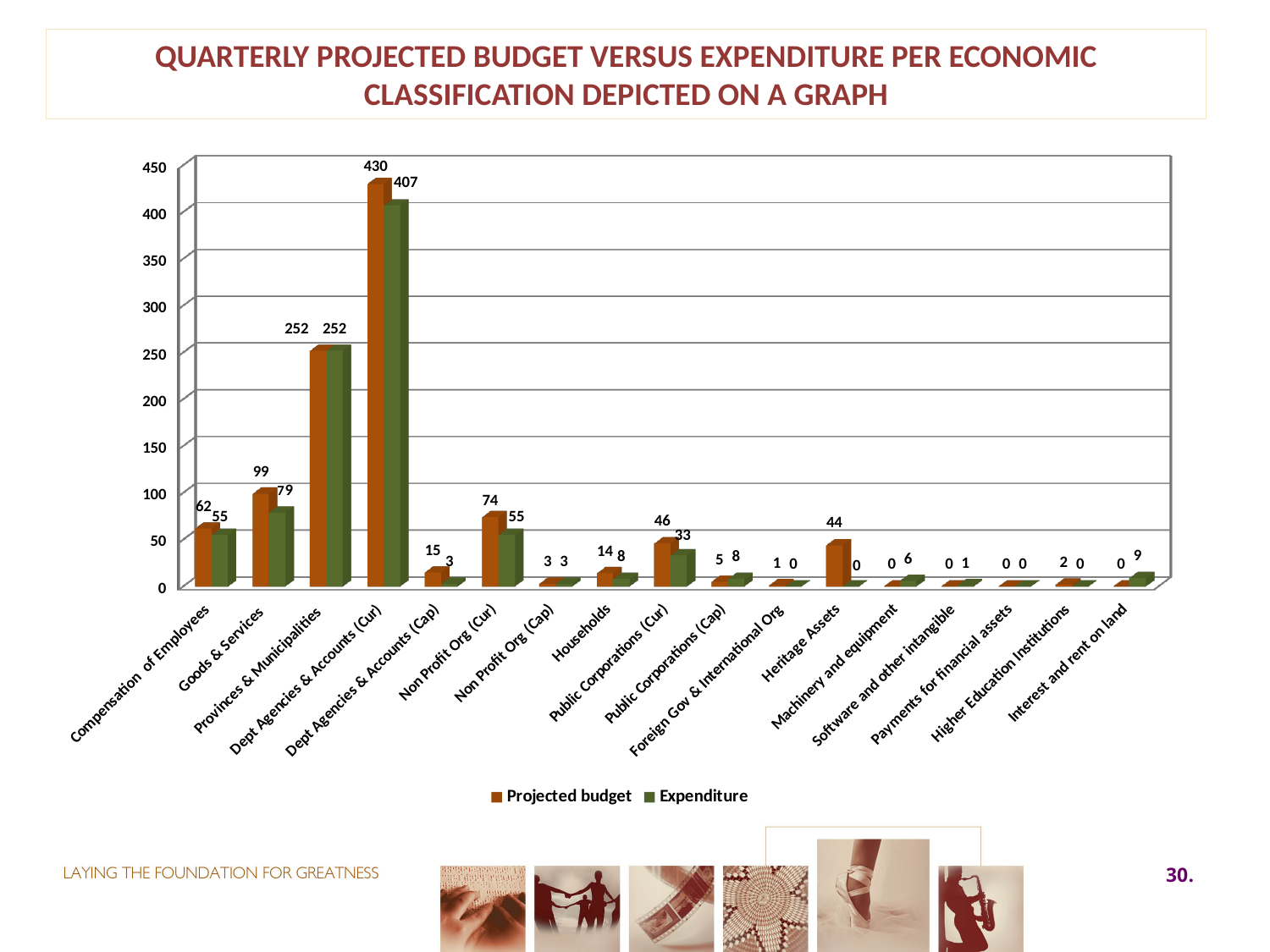
What is the Projected budget value for Dept Agencies & Accounts (Cur)? 430 How many series does the legend list? 2 Is the Projected budget for Provinces & Municipalities greater or less than 200? greater How many categories are shown on the x axis? 17 What is the difference between the Projected budget and Expenditure for Goods & Services? 20 What kind of chart is shown on the slide? Bar chart Which is larger for Public Corporations (Cap): the Projected budget or the Expenditure? Expenditure Which category has the highest Projected budget? Dept Agencies & Accounts (Cur) What are the two series named in the legend? Projected budget and Expenditure What is the difference between the Projected budget and Expenditure for Dept Agencies & Accounts (Cur)? 23 What is the Expenditure value for Heritage Assets? 0 What is the Expenditure value for Goods & Services? 79